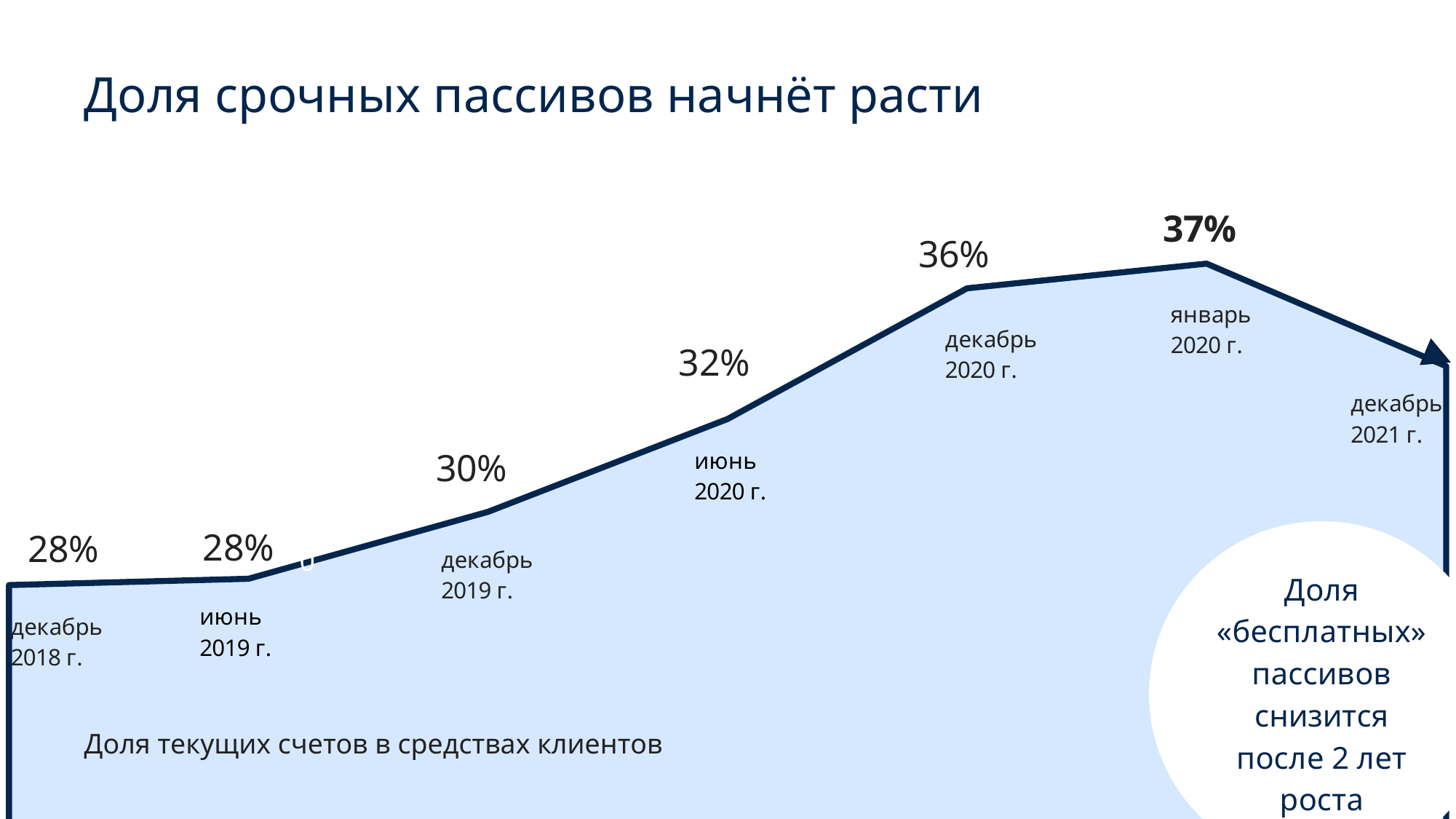
What is the title of the chart on the slide? Доля текущих счетов в средствах клиентов What is the value for декабрь 2019 г. in the chart 'Доля текущих счетов в средствах клиентов'? 30% Which is larger: the value for июнь 2019 г. or the value for декабрь 2019 г.? декабрь 2019 г. What is the value for декабрь 2018 г. in the chart? 28% What is the value for декабрь 2020 г. in the chart? 36% What kind of chart is shown on the slide? area chart What is the difference between the values for декабрь 2020 г. and июнь 2020 г.? 4 percentage points How many data points have a percentage value printed on the chart? 6 What is the value for июнь 2020 г. in the chart? 32% Do the values rise or fall from декабрь 2018 г. to январь 2020 г.? rise What is the difference between the values for январь 2020 г. and декабрь 2018 г.? 9 percentage points Which labeled date has the highest value in the chart? январь 2020 г.